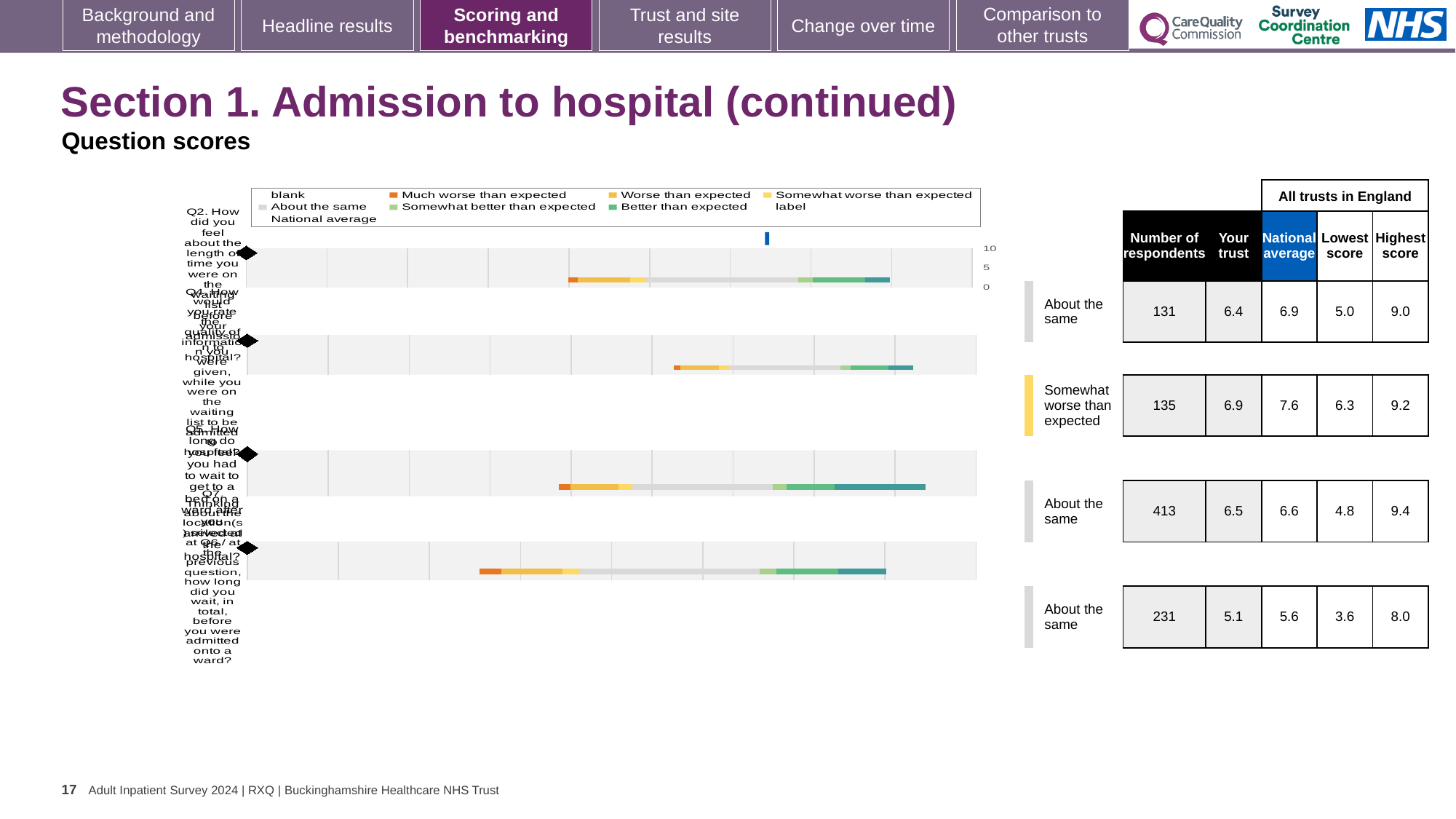
In the table, what is the difference between the national average and the trust score in the second row? 0.7 In the table, what is the lowest 'Your trust' score listed? 5.1 In the table, what is the 'National average' score in the second row? 7.6 How many of the four question bars are labelled 'About the same'? 3 In the table, which row has the highest number of respondents? the third row (413) In the table, what is the 'Your trust' score in the first row? 6.4 In the fourth row of the table, which is larger: the 'Your trust' score or the 'National average'? National average How many question bars are plotted in the chart? 4 What is the maximum value shown on the chart's score axis? 10 What kind of chart is shown on the slide? bar chart In the table, what is the 'Highest score' in the third row? 9.4 What benchmark label is given to the second question bar? Somewhat worse than expected